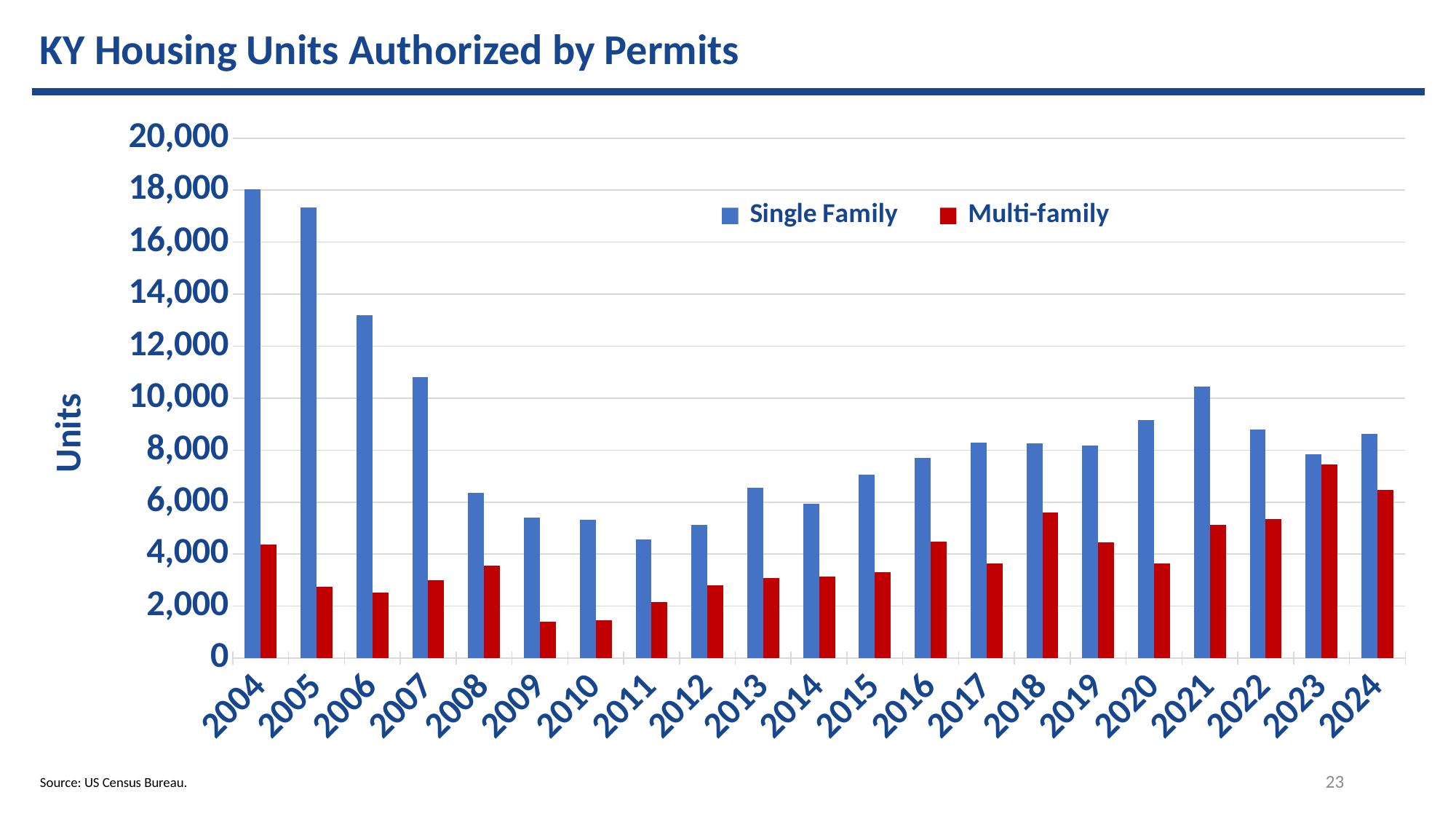
Is the Single Family value for 2004 greater or less than 16,000? greater Is the Multi-family value for 2009 greater or less than 2,000? less Is the Single Family value for 2011 greater or less than 6,000? less Do Single Family values rise or fall from 2004 to 2011? fall What kind of chart is shown on the slide? Bar chart Which year has the highest Multi-family value? 2023 What is the label on the y axis? Units How many series does the legend list? 2 How many years are shown on the x axis? 21 Which is larger in 2004, the Single Family value or the Multi-family value? Single Family Which year has the lowest Single Family value? 2011 Which year has the highest Single Family value? 2004